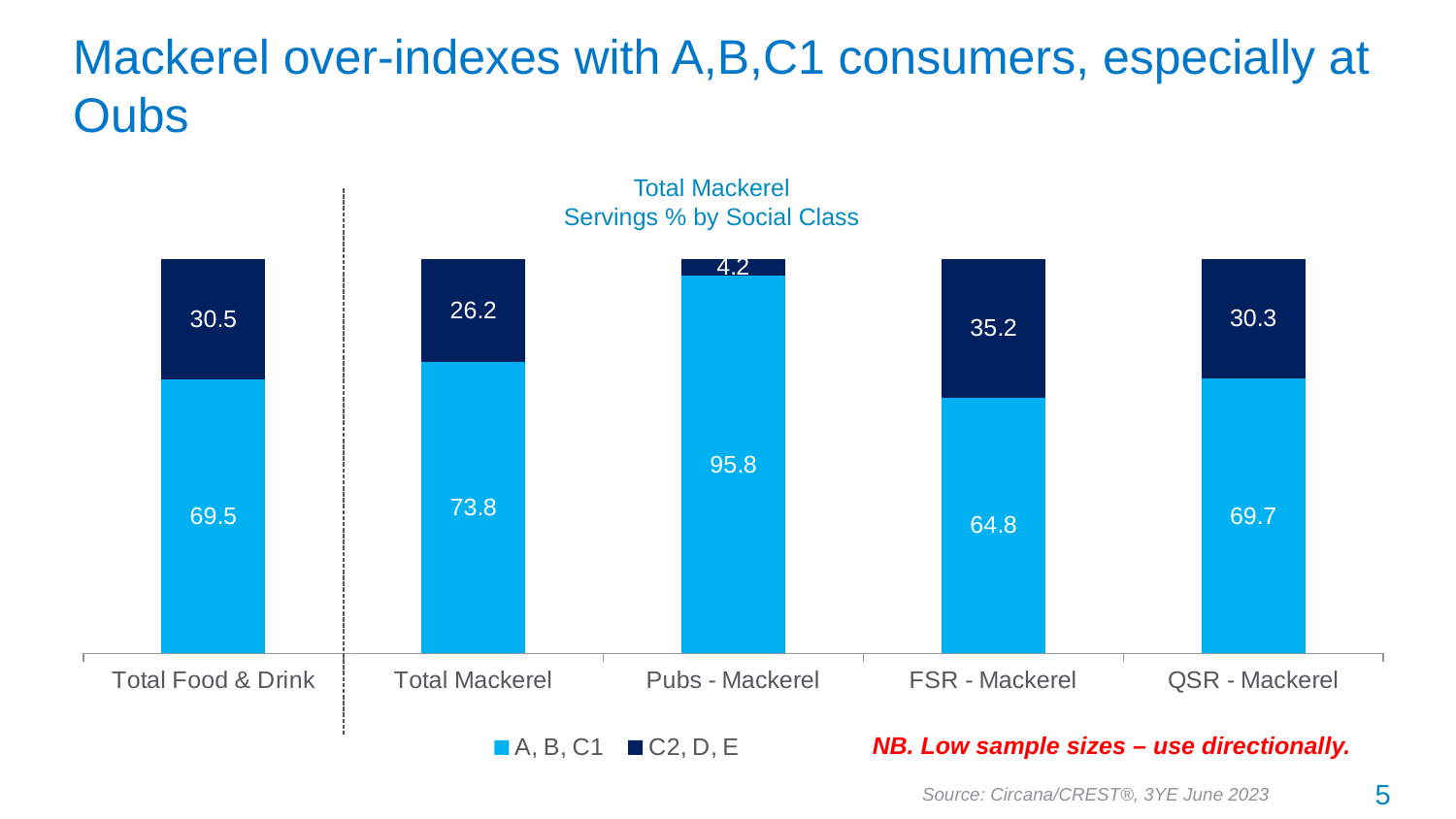
What kind of chart is shown on the slide? Stacked bar chart Which category has the lowest C2, D, E value? Pubs - Mackerel Is the C2, D, E value larger for Total Food & Drink or for Total Mackerel? Total Food & Drink Which category has the highest A, B, C1 value? Pubs - Mackerel What is the C2, D, E value for FSR - Mackerel? 35.2 What is the A, B, C1 value for Pubs - Mackerel? 95.8 What is the C2, D, E value for Total Mackerel? 26.2 What is the A, B, C1 value for Total Food & Drink? 69.5 What is the difference between the A, B, C1 values for Pubs - Mackerel and FSR - Mackerel? 31.0 Which category has the lowest A, B, C1 value? FSR - Mackerel How many series does the legend list? 2 How many categories are shown on the x axis? 5